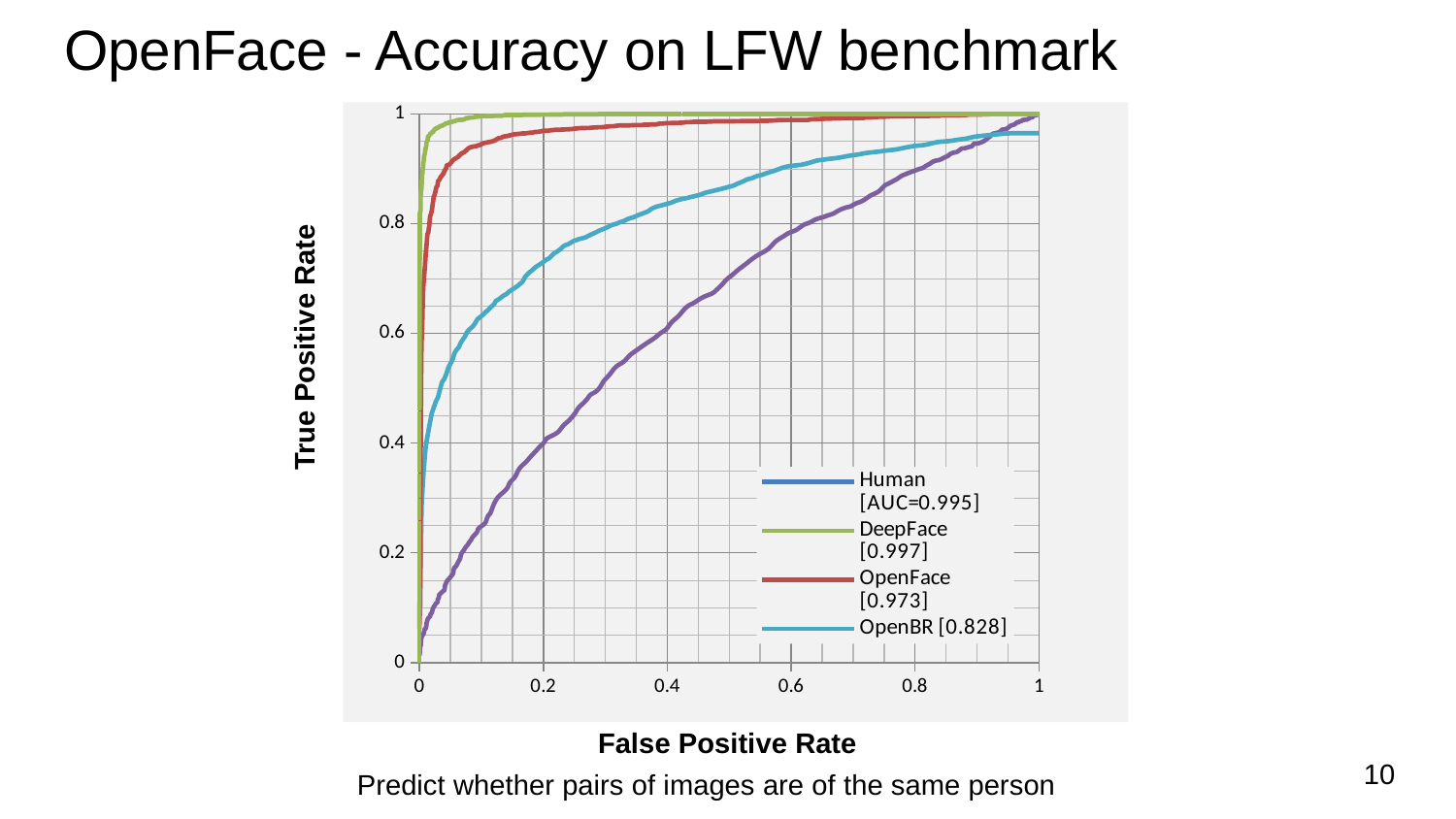
What is the AUC value shown for OpenFace in the legend? 0.973 What is the AUC value shown for Human in the legend? 0.995 Which has a higher AUC value, Human or DeepFace? DeepFace What is the AUC value shown for OpenBR in the legend? 0.828 What is the AUC value shown for DeepFace in the legend? 0.997 Is the True Positive Rate of the OpenBR curve at a False Positive Rate of 0.2 greater or less than 0.6? greater How many series does the legend list? 4 Which legend entry has the highest AUC value? DeepFace What kind of chart is shown on the slide? line chart What is the label of the x axis? False Positive Rate Which legend entry has the lowest AUC value? OpenBR What is the difference between the AUC values of DeepFace and OpenFace? 0.024